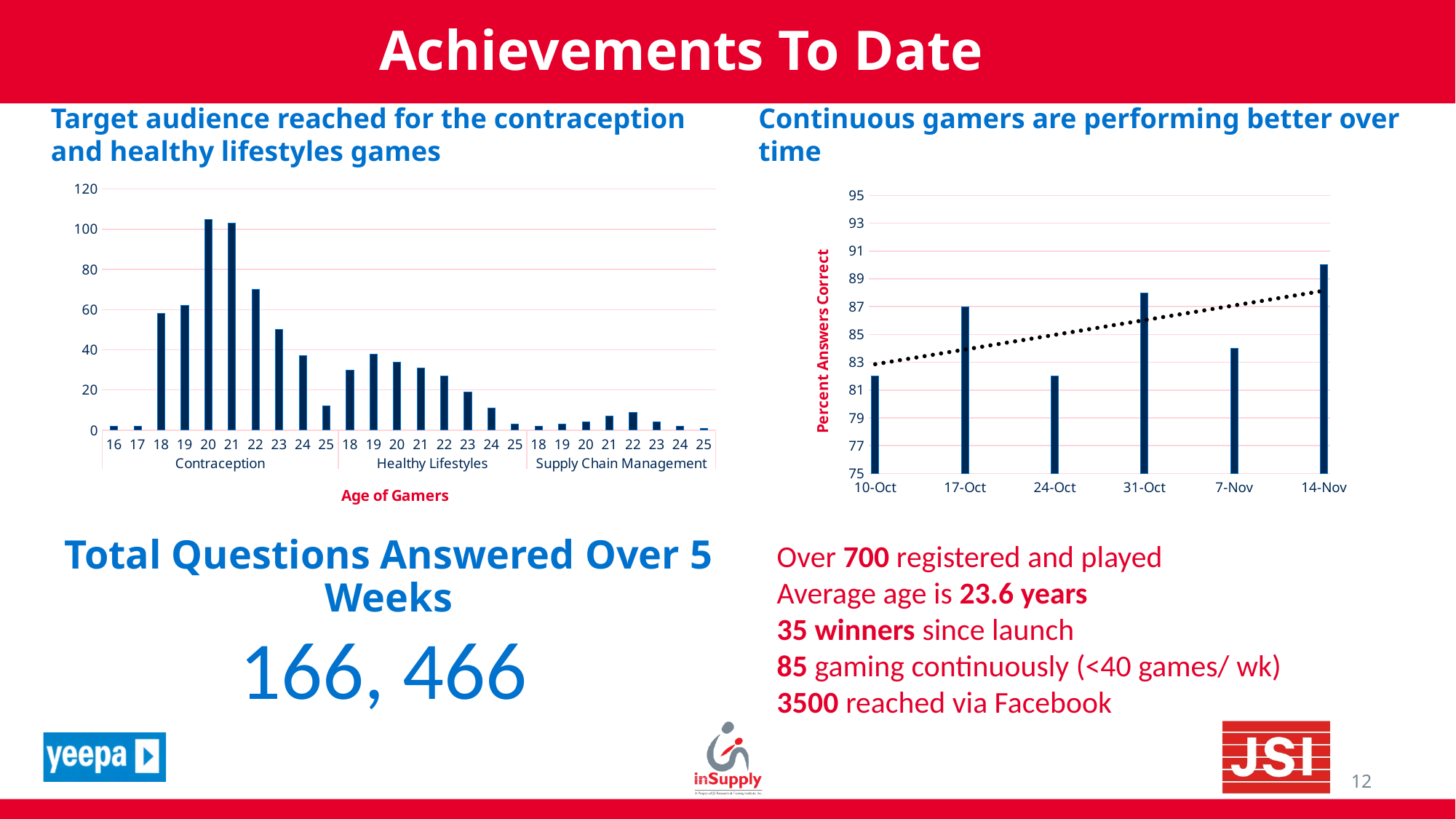
In the left chart, is the value for age 20 in the Contraception group greater or less than 100? greater In the left chart, is the value for age 18 in the Healthy Lifestyles group greater or less than 20? greater In the right chart, which date has the highest percent of answers correct? 14-Nov What kind of chart is the left chart, 'Target audience reached for the contraception and healthy lifestyles games'? bar chart In the left chart, which is larger: the value for age 22 in Contraception or age 22 in Healthy Lifestyles? Contraception In the left chart, which age in the Contraception group has the tallest bar? 20 How many game groups are shown along the x axis of the left chart? 3 In the right chart, which is larger: the value for 17-Oct or the value for 7-Nov? 17-Oct How many dates are shown on the x axis of the right chart? 6 What is the x-axis title of the left chart? Age of Gamers In the right chart, is the value for 14-Nov greater or less than 89? greater What kind of chart is the right chart, 'Continuous gamers are performing better over time'? bar chart